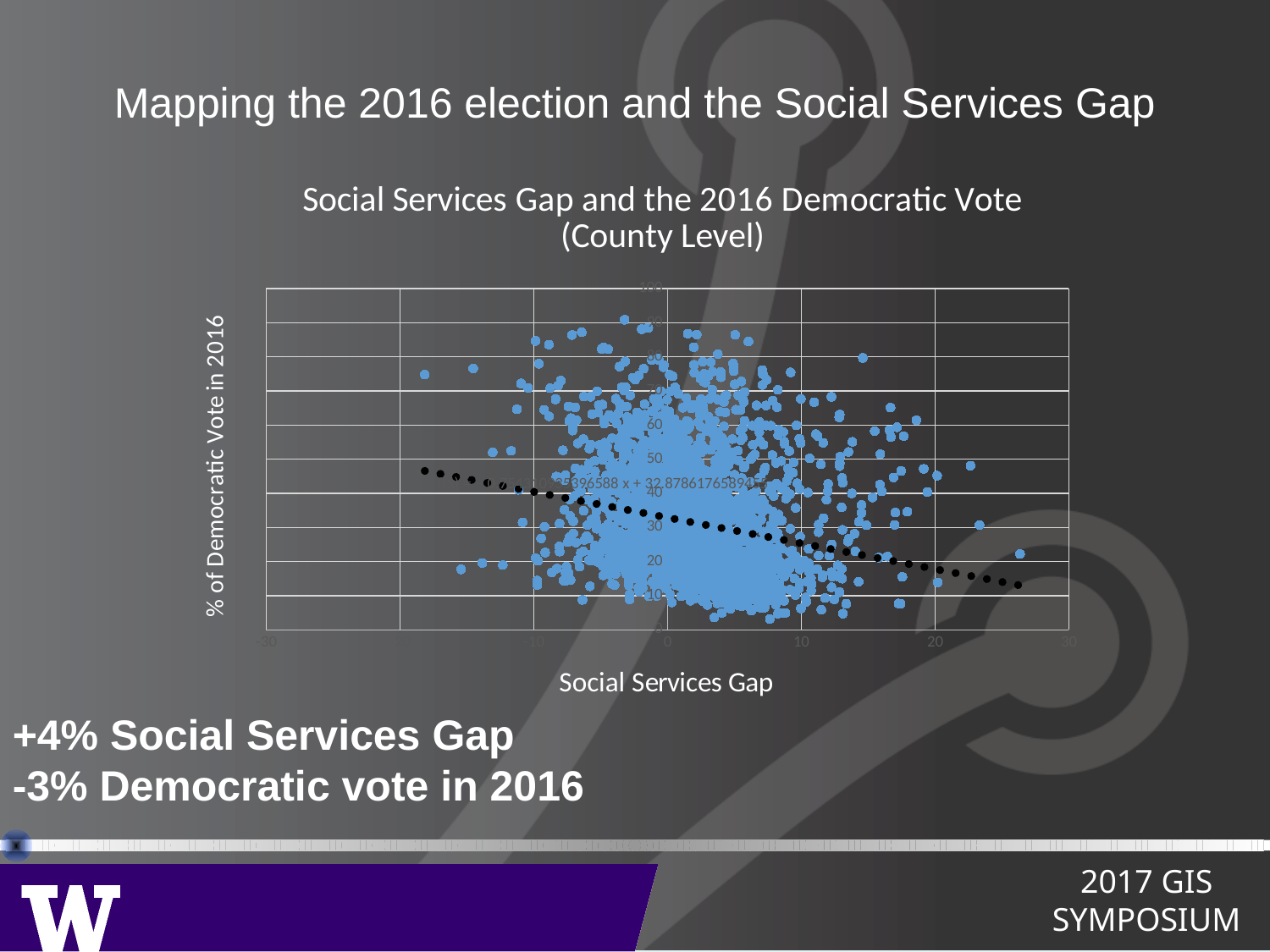
What is the label of the x axis of the chart? Social Services Gap According to the trendline, does the % of Democratic Vote in 2016 tend to increase or decrease as the Social Services Gap increases? decrease What kind of chart is shown on the slide? scatter plot Is the trendline's value at a Social Services Gap of 20 greater or less than 30? less What is the title of the chart? Social Services Gap and the 2016 Democratic Vote (County Level) Is the trendline's value at a Social Services Gap of 0 greater or less than 50? less What is the lowest value shown on the x axis of the chart? -30 Does the dotted trendline rise or fall as the Social Services Gap increases? fall Is the trendline's value at a Social Services Gap of -20 greater or less than 40? greater What is the highest value shown on the x axis of the chart? 30